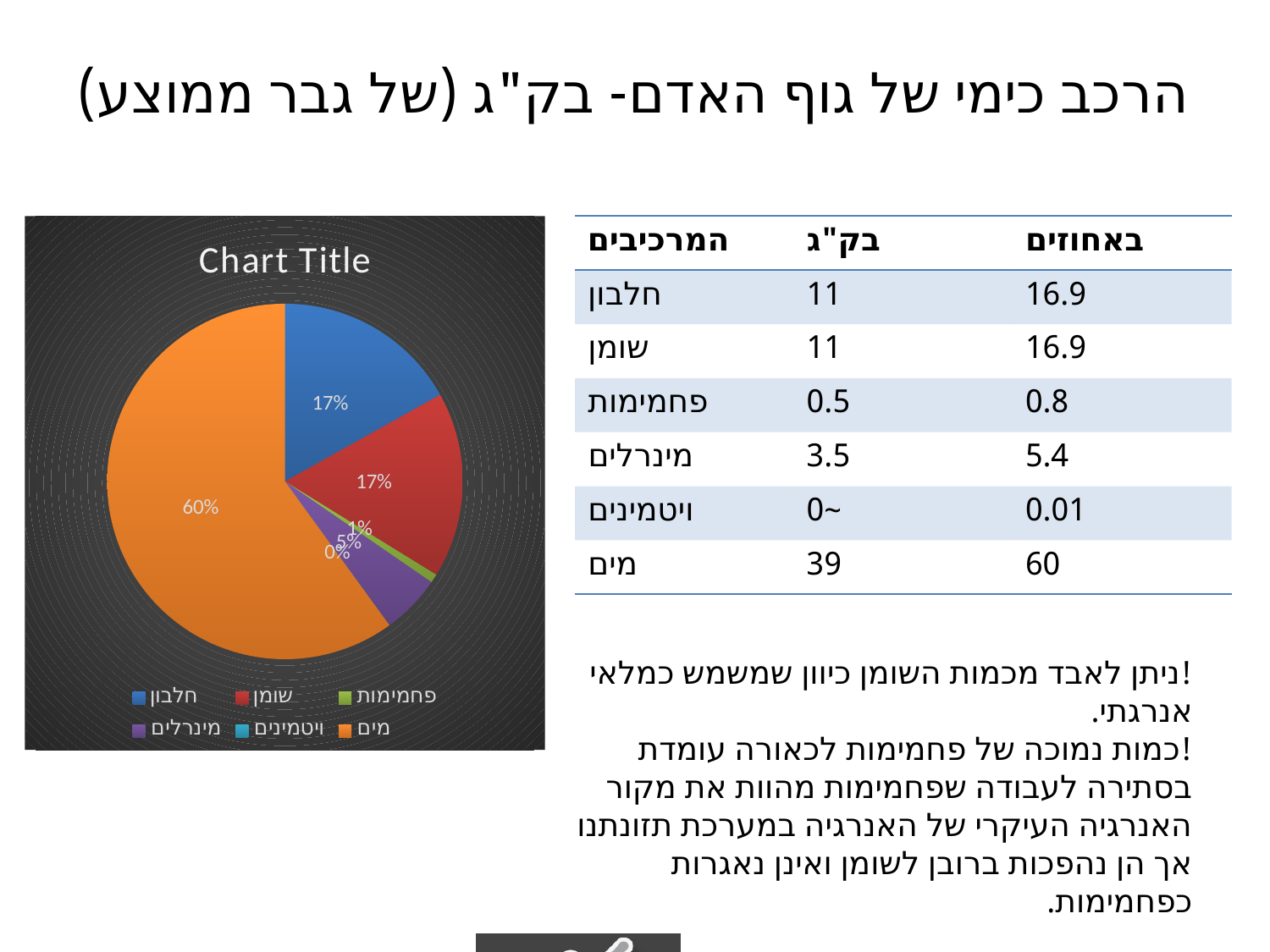
How many categories does the chart's legend list? 6 Which category has the largest slice of the pie? מים What percentage of the pie does מינרלים (minerals) take up? 5% Which is larger, the slice for מינרלים or the slice for פחמימות? מינרלים What percentage of the pie does שומן (fat) take up? 17% What percentage of the pie does חלבון (protein) take up? 17% Which is larger, the slice for מים or the slice for חלבון? מים What kind of chart is shown on the slide? pie chart What is the title of the chart? Chart Title Which colour represents מים in the chart? orange What is the difference between the share for מים and the share for מינרלים? 55%